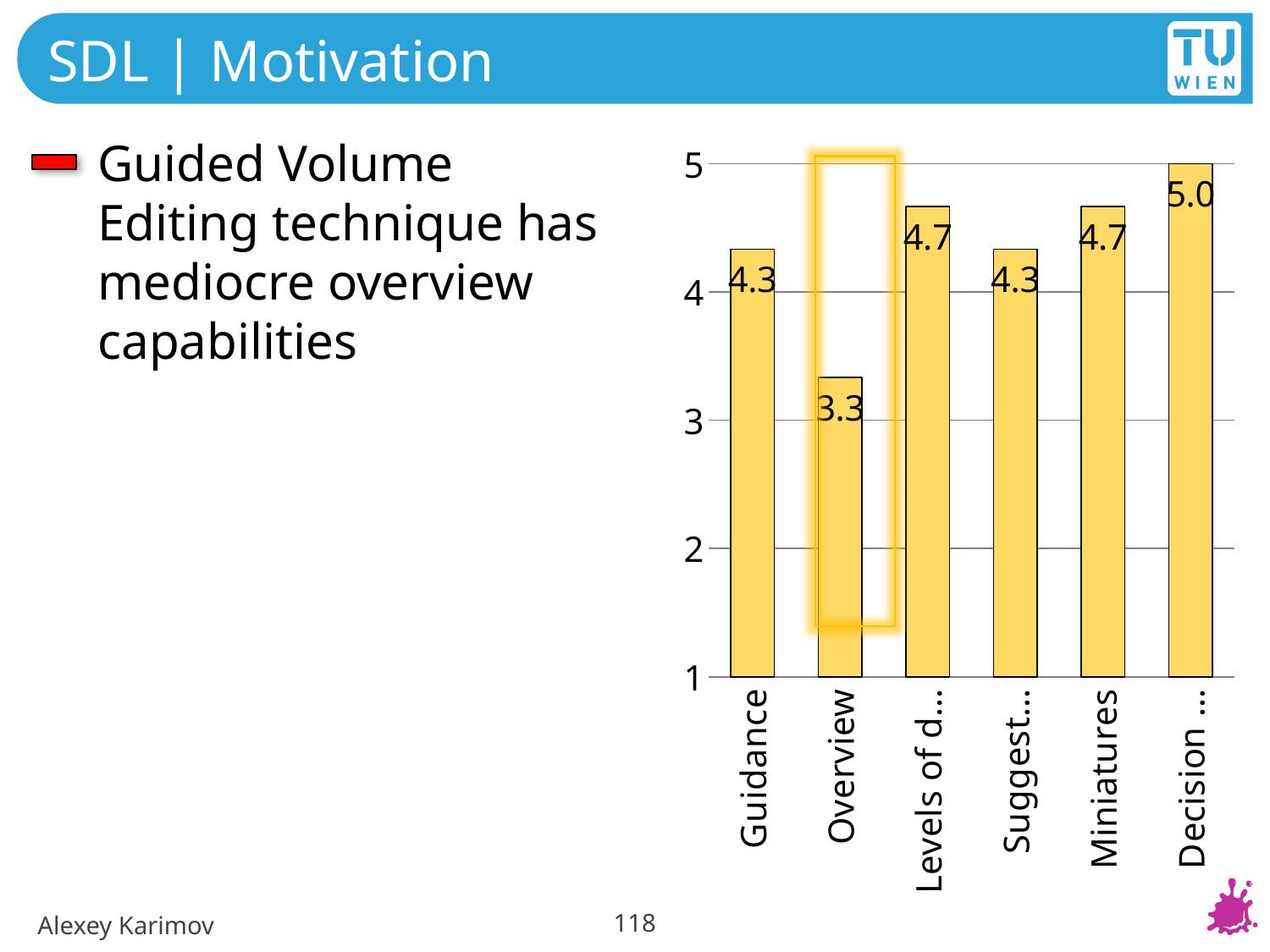
What is the value for Miniatures? 4.7 Which is larger, the value for Guidance or the value for Miniatures? Miniatures What is the difference between the values for Guidance and Overview? 1.0 What is the value for Guidance? 4.3 How many bars are in the chart? 6 What is the value of the rightmost bar in the chart? 5.0 Is the value for Overview greater or less than 4? less What is the difference between the values for Miniatures and Overview? 1.4 What is the value for Overview? 3.3 Which category has the lowest value? Overview Which bar is outlined with a highlight box? Overview What kind of chart is shown on the slide? bar chart